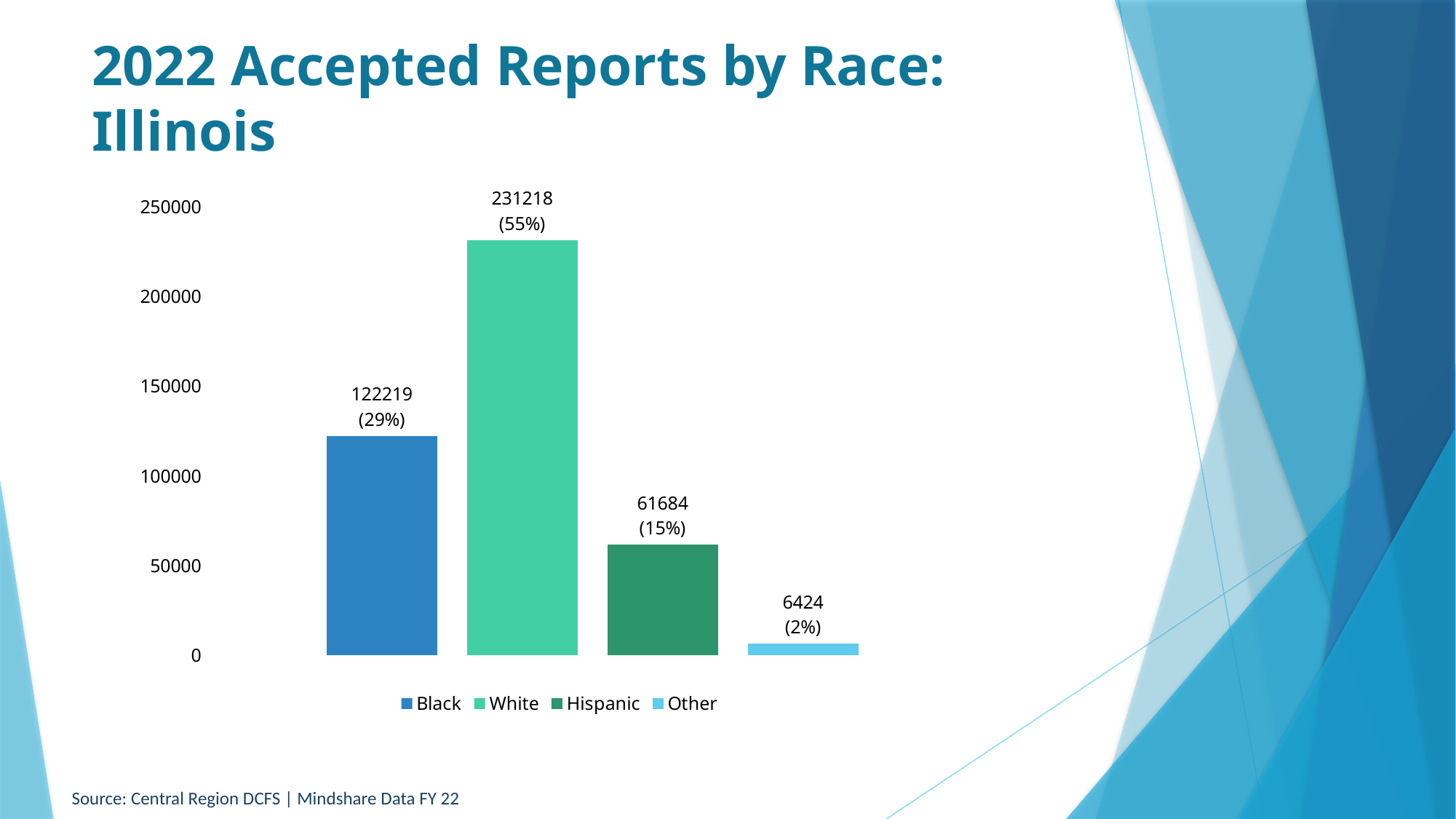
Is the value for Hispanic greater or less than 100000? less What percentage of accepted reports is shown for Other? 2% Which race category has the highest number of accepted reports? White What is the number of accepted reports for Black? 122219 What is the number of accepted reports for Hispanic? 61684 How many race categories are shown in the chart? 4 What is the number of accepted reports for White? 231218 What is the title of the slide? 2022 Accepted Reports by Race: Illinois What kind of chart is shown on the slide? Bar chart What is the difference between the accepted reports for White and Black? 108999 Which has more accepted reports, Black or Hispanic? Black Which race category has the lowest number of accepted reports? Other